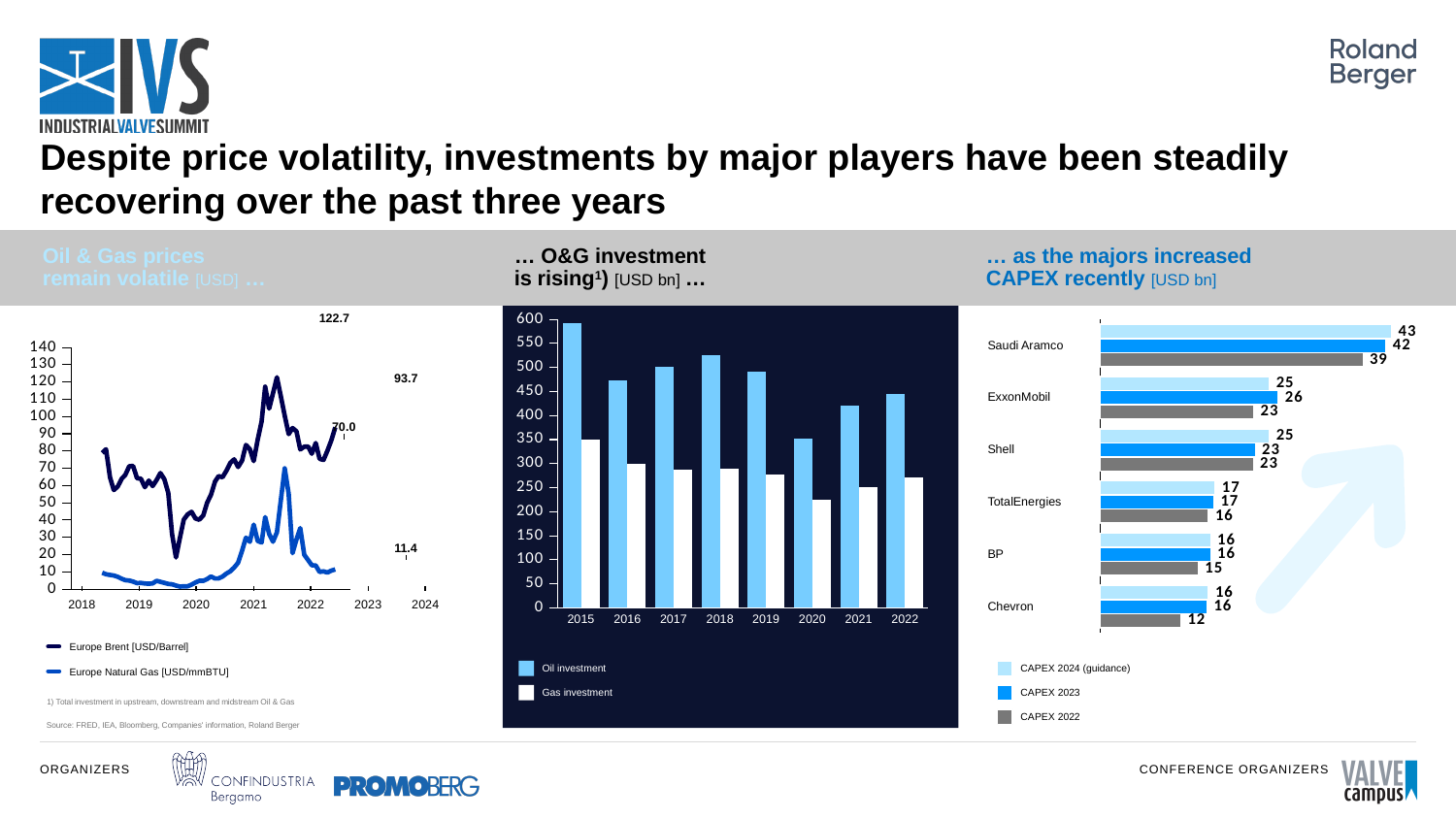
On the right chart ("… as the majors increased CAPEX recently"), what is the CAPEX 2022 value for Chevron? 12 On the right chart ("… as the majors increased CAPEX recently"), which company has the highest CAPEX 2023? Saudi Aramco On the right chart ("… as the majors increased CAPEX recently"), what is the difference between Saudi Aramco's CAPEX 2024 (guidance) and its CAPEX 2022? 4 On the right chart ("… as the majors increased CAPEX recently"), how many companies are shown? 6 On the left chart ("Oil & Gas prices remain volatile"), how many series does the legend list? 2 On the middle chart ("… O&G investment is rising"), is the Oil investment value for 2015 greater or less than 550? greater On the middle chart ("… O&G investment is rising"), is the Gas investment value for 2020 greater or less than 250? less On the left chart ("Oil & Gas prices remain volatile"), what is the peak value labelled for Europe Brent? 122.7 On the right chart ("… as the majors increased CAPEX recently"), which company has the lowest CAPEX 2022? Chevron On the right chart ("… as the majors increased CAPEX recently"), what is the CAPEX 2024 (guidance) value for Saudi Aramco? 43 What kind of chart is the middle chart ("… O&G investment is rising")? Bar chart On the right chart ("… as the majors increased CAPEX recently"), how many series does the legend list? 3